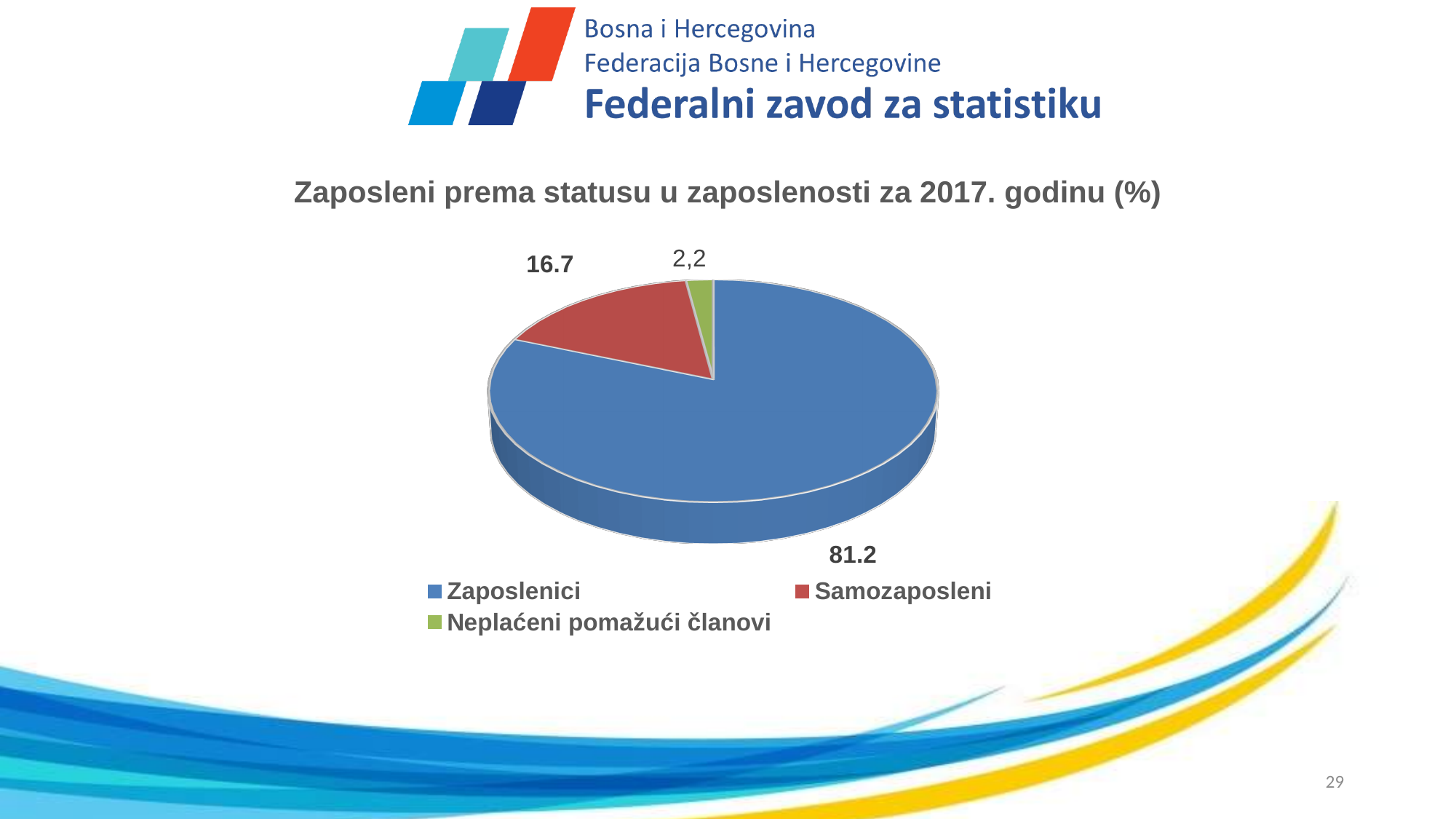
Which category has the largest slice of the pie? Zaposlenici What is the difference between the values for Zaposlenici and Samozaposleni? 64.5 Which is larger, the value for Samozaposleni or the value for Neplaćeni pomažući članovi? Samozaposleni What share of the pie does Zaposlenici represent? 81.2% What is the value for Neplaćeni pomažući članovi in the pie chart? 2,2 How many categories does the pie chart show? 3 What colour is the slice for Samozaposleni? red What is the value for Zaposlenici in the pie chart? 81.2 What is the value for Samozaposleni in the pie chart? 16.7 What kind of chart is shown on the slide? pie chart What is the title of the chart? Zaposleni prema statusu u zaposlenosti za 2017. godinu (%) Which category has the smallest slice of the pie? Neplaćeni pomažući članovi